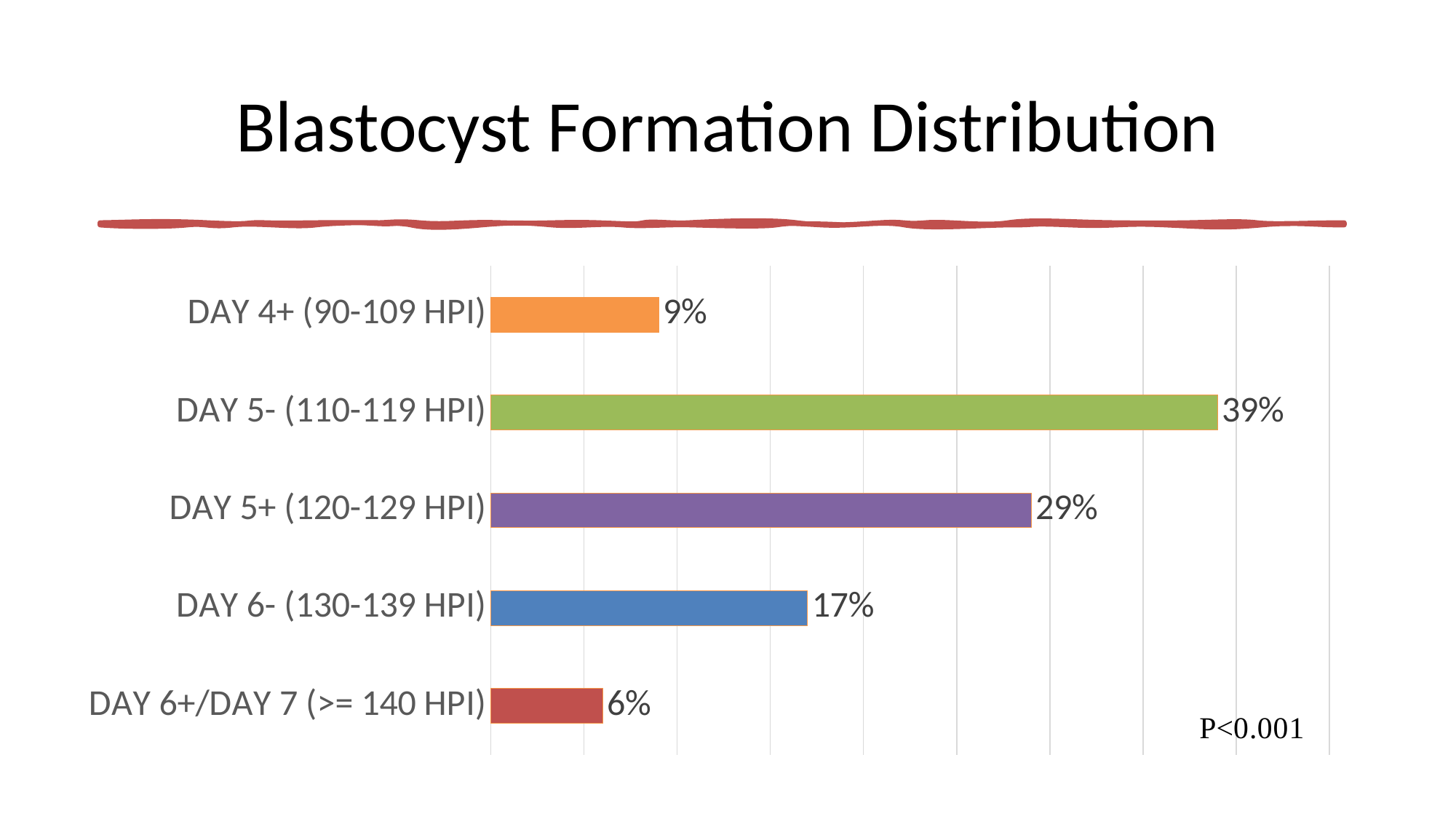
How many categories are shown in the chart? 5 What colour is the bar for DAY 5+ (120-129 HPI)? Purple Which is larger, the value for DAY 5+ (120-129 HPI) or DAY 6- (130-139 HPI)? DAY 5+ (120-129 HPI) What is the difference between the values for DAY 4+ (90-109 HPI) and DAY 6+/DAY 7 (>= 140 HPI)? 3% What is the difference between the values for DAY 5- (110-119 HPI) and DAY 5+ (120-129 HPI)? 10% What is the title of the slide? Blastocyst Formation Distribution What is the value for DAY 6- (130-139 HPI)? 17% Which category has the highest value? DAY 5- (110-119 HPI) What kind of chart is shown on the slide? Bar chart What is the value for DAY 5- (110-119 HPI)? 39% Which category has the lowest value? DAY 6+/DAY 7 (>= 140 HPI) What is the value for DAY 6+/DAY 7 (>= 140 HPI)? 6%